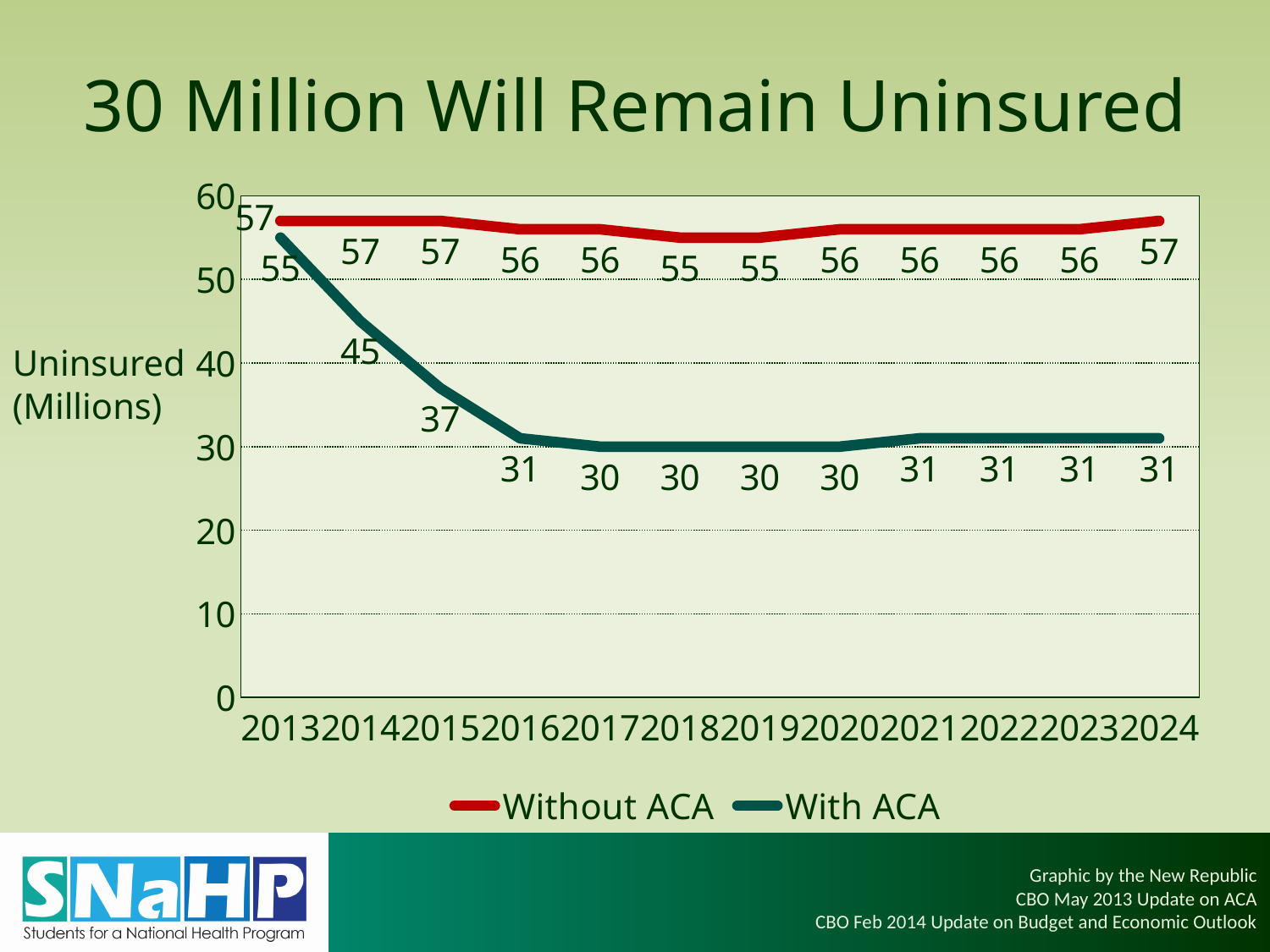
What is the value for Without ACA in 2018? 55 In which year is the With ACA series highest? 2013 What is the difference between Without ACA and With ACA in 2016? 25 Does the With ACA series rise or fall from 2013 to 2016? Fall What is the title of the chart? 30 Million Will Remain Uninsured How many series does the legend list? 2 What is the difference between the With ACA values in 2013 and 2014? 10 What is the value for With ACA in 2015? 37 Which series has the larger value in 2020, Without ACA or With ACA? Without ACA What is the value for With ACA in 2024? 31 What type of chart is shown on the slide? Line chart How many years are plotted on the x axis? 12